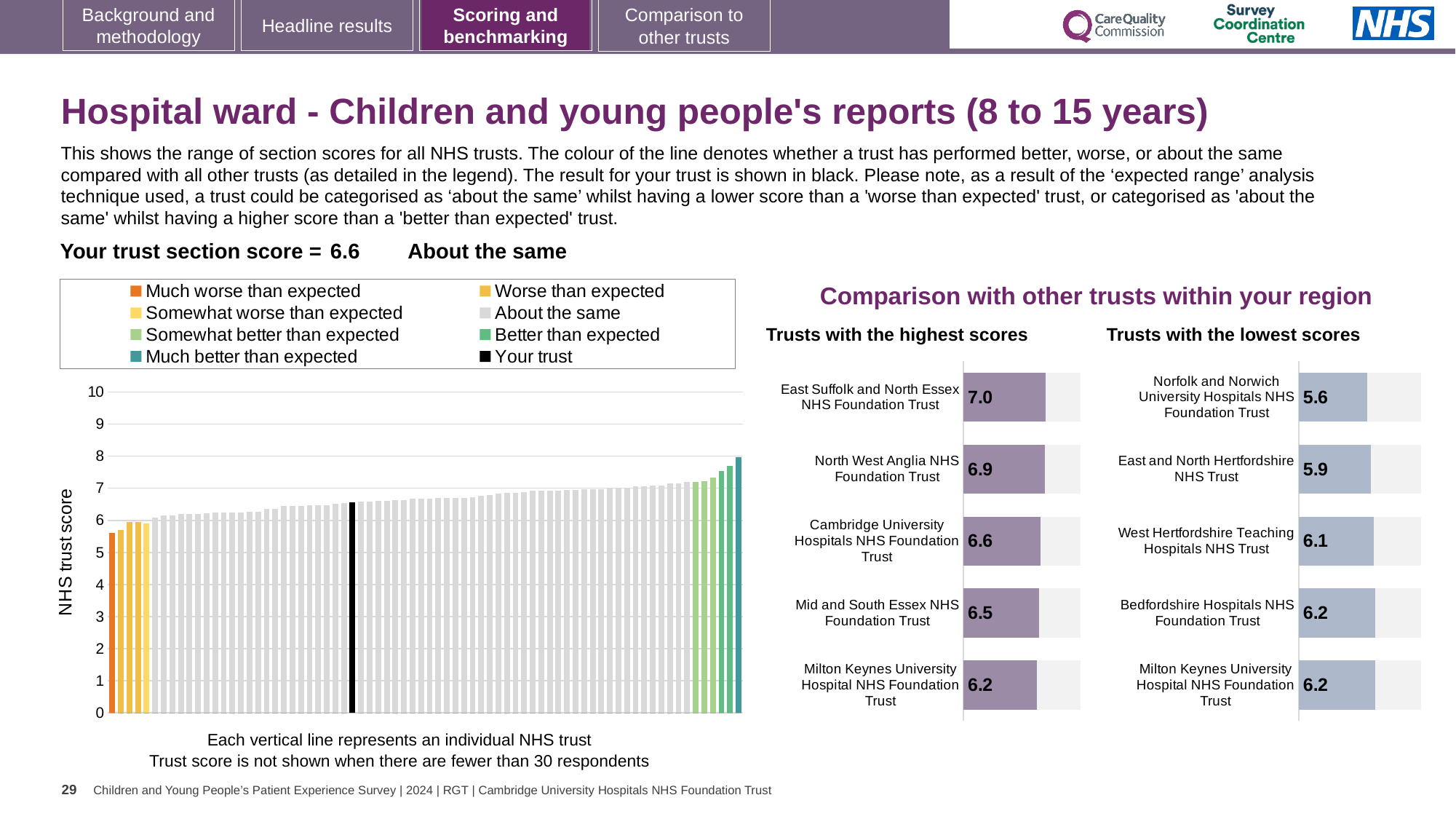
In the 'Trusts with the lowest scores' chart, which has the higher score: East and North Hertfordshire NHS Trust or West Hertfordshire Teaching Hospitals NHS Trust? West Hertfordshire Teaching Hospitals NHS Trust In the 'Trusts with the lowest scores' chart, which trust has the lowest score? Norfolk and Norwich University Hospitals NHS Foundation Trust In the 'Trusts with the lowest scores' chart, what is the score for Norfolk and Norwich University Hospitals NHS Foundation Trust? 5.6 What kind of chart is the large chart on the left showing NHS trust scores? Bar chart In the large chart on the left, what is the section score for your trust (the black bar)? 6.6 In the 'Trusts with the lowest scores' chart, what is the difference between the scores of Bedfordshire Hospitals NHS Foundation Trust and Norfolk and Norwich University Hospitals NHS Foundation Trust? 0.6 How many entries does the legend of the large chart on the left list? 8 In the 'Trusts with the highest scores' chart, which trust has the highest score? East Suffolk and North Essex NHS Foundation Trust In the 'Trusts with the highest scores' chart, what is the score for East Suffolk and North Essex NHS Foundation Trust? 7.0 How many trusts are shown in the 'Trusts with the highest scores' chart? 5 In the 'Trusts with the highest scores' chart, what is the difference between the scores of East Suffolk and North Essex NHS Foundation Trust and Milton Keynes University Hospital NHS Foundation Trust? 0.8 In the large chart on the left, do the trust scores rise or fall from left to right? Rise